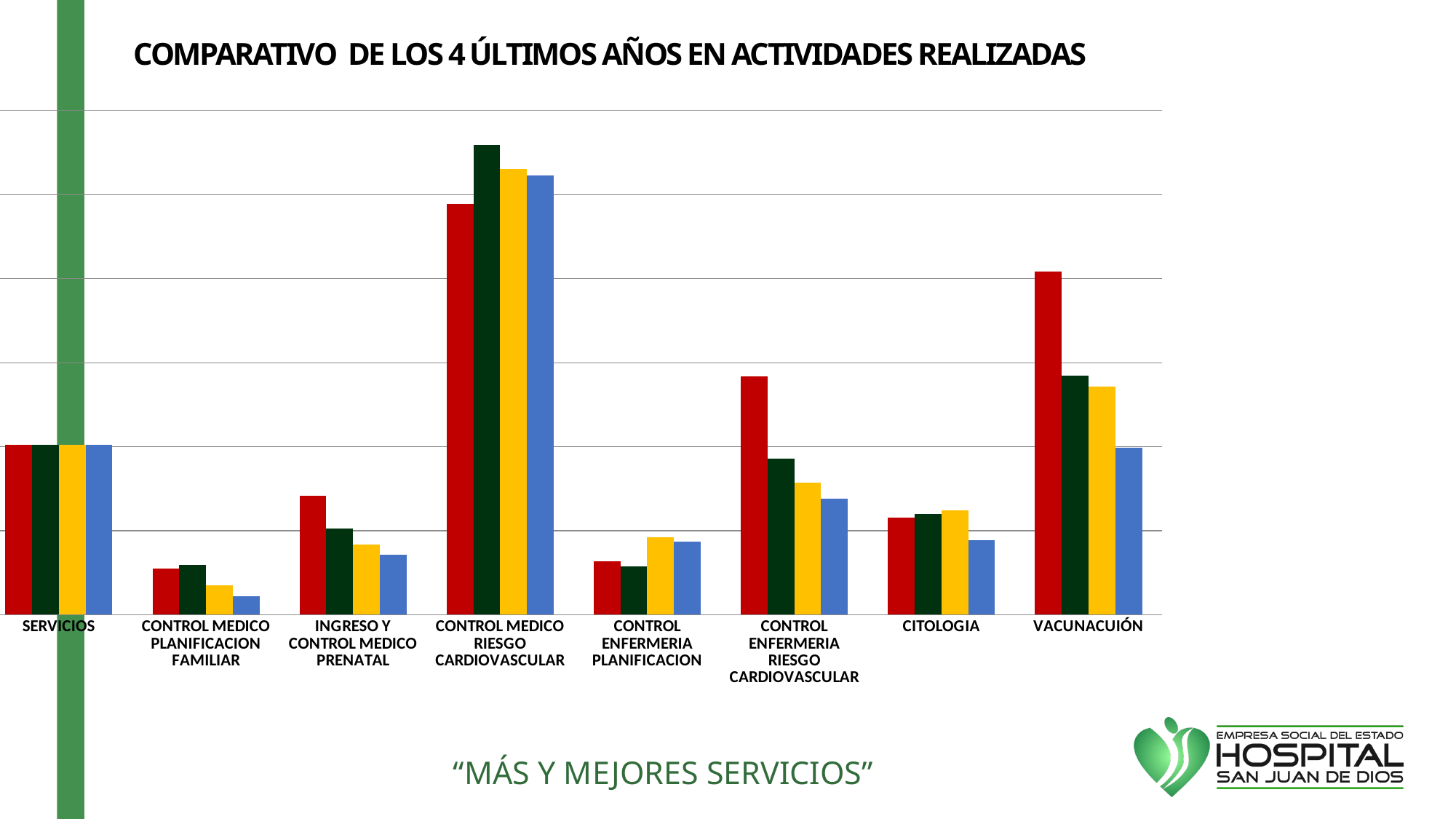
What four colours are used for the bars in the chart? Red, dark green, yellow and blue Which category has the tallest bars in the chart? CONTROL MEDICO RIESGO CARDIOVASCULAR How many categories are shown along the x axis of the chart? 8 Within the VACUNACUIÓN category, do the bars rise or fall from left to right? Fall Which category contains the shortest bar in the chart? CONTROL MEDICO PLANIFICACION FAMILIAR Which has the taller red bar: CITOLOGIA or INGRESO Y CONTROL MEDICO PRENATAL? INGRESO Y CONTROL MEDICO PRENATAL Within the CONTROL ENFERMERIA RIESGO CARDIOVASCULAR category, do the bars rise or fall from left to right? Fall Which has the taller red bar: VACUNACUIÓN or CONTROL ENFERMERIA RIESGO CARDIOVASCULAR? VACUNACUIÓN What is the title of the chart? COMPARATIVO DE LOS 4 ÚLTIMOS AÑOS EN ACTIVIDADES REALIZADAS What kind of chart is shown on the slide? Bar chart How many bars are plotted for each category in the chart? 4 Within the CONTROL MEDICO RIESGO CARDIOVASCULAR category, which coloured bar is the tallest? Dark green